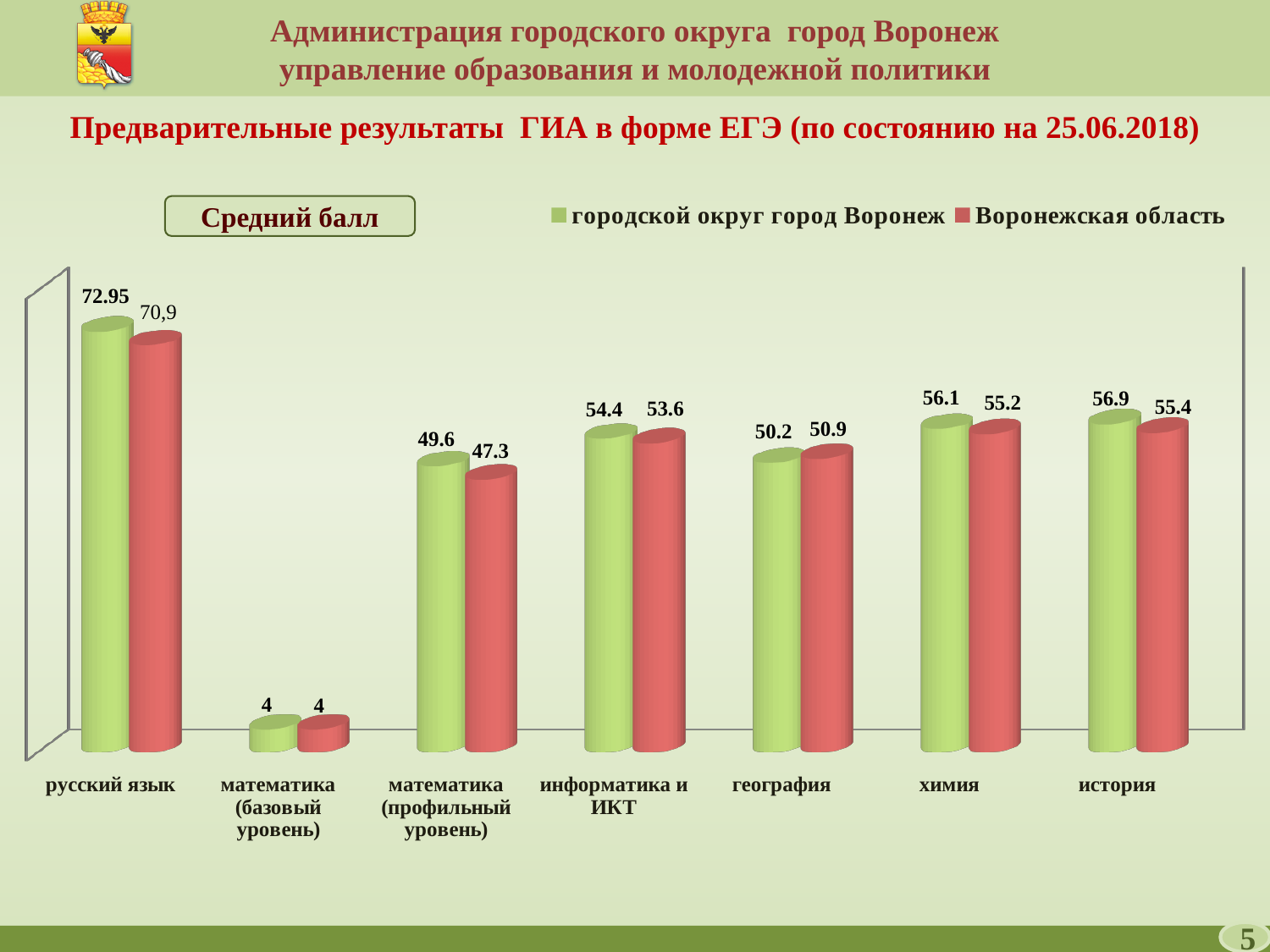
Which category has the highest value for городской округ город Воронеж? русский язык What is the value for городской округ город Воронеж in русский язык? 72.95 How many series does the legend list? 2 What is the value for Воронежская область in география? 50.9 Which is larger in география: городской округ город Воронеж or Воронежская область? Воронежская область How many categories are shown on the x axis? 7 Which colour represents Воронежская область in the chart? red What kind of chart is shown on the slide? bar chart What is the value for Воронежская область in математика (профильный уровень)? 47.3 What is the value for городской округ город Воронеж in химия? 56.1 Which category has the lowest value for Воронежская область? математика (базовый уровень) What is the difference between городской округ город Воронеж and Воронежская область in информатика и ИКТ? 0.8